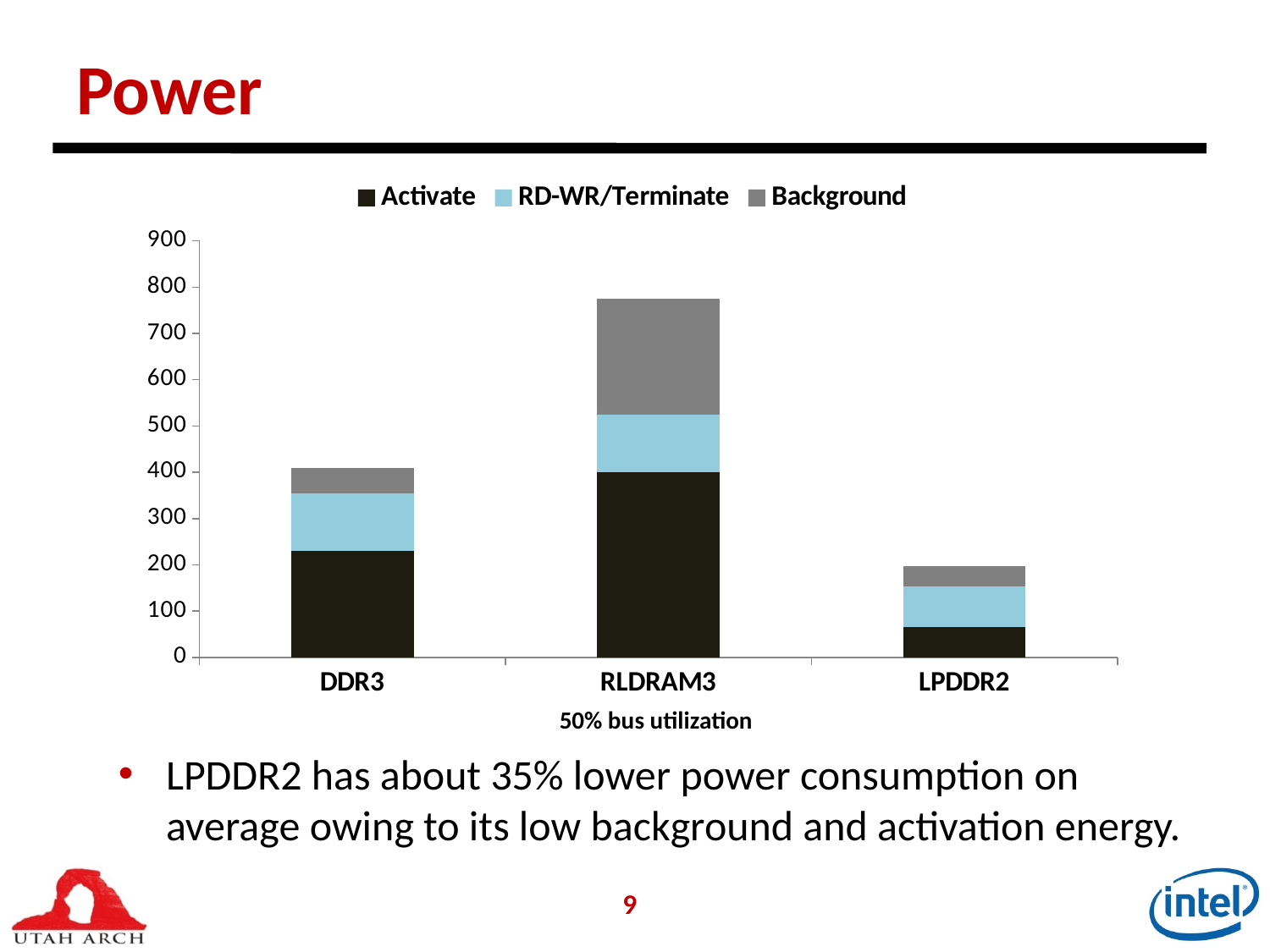
Which has a larger total bar, DDR3 or LPDDR2? DDR3 How many memory types (categories) are shown on the x axis of the chart? 3 How many series does the chart's legend list? 3 Is the Activate value for LPDDR2 greater or less than 100? less What kind of chart is shown on the slide? Stacked bar chart Is the total stacked value for LPDDR2 greater or less than 300? less What label appears below the x axis of the chart? 50% bus utilization Which memory type has the highest total stacked bar in the chart? RLDRAM3 Is the Activate value for DDR3 greater or less than 200? greater Which memory type has the lowest total stacked bar in the chart? LPDDR2